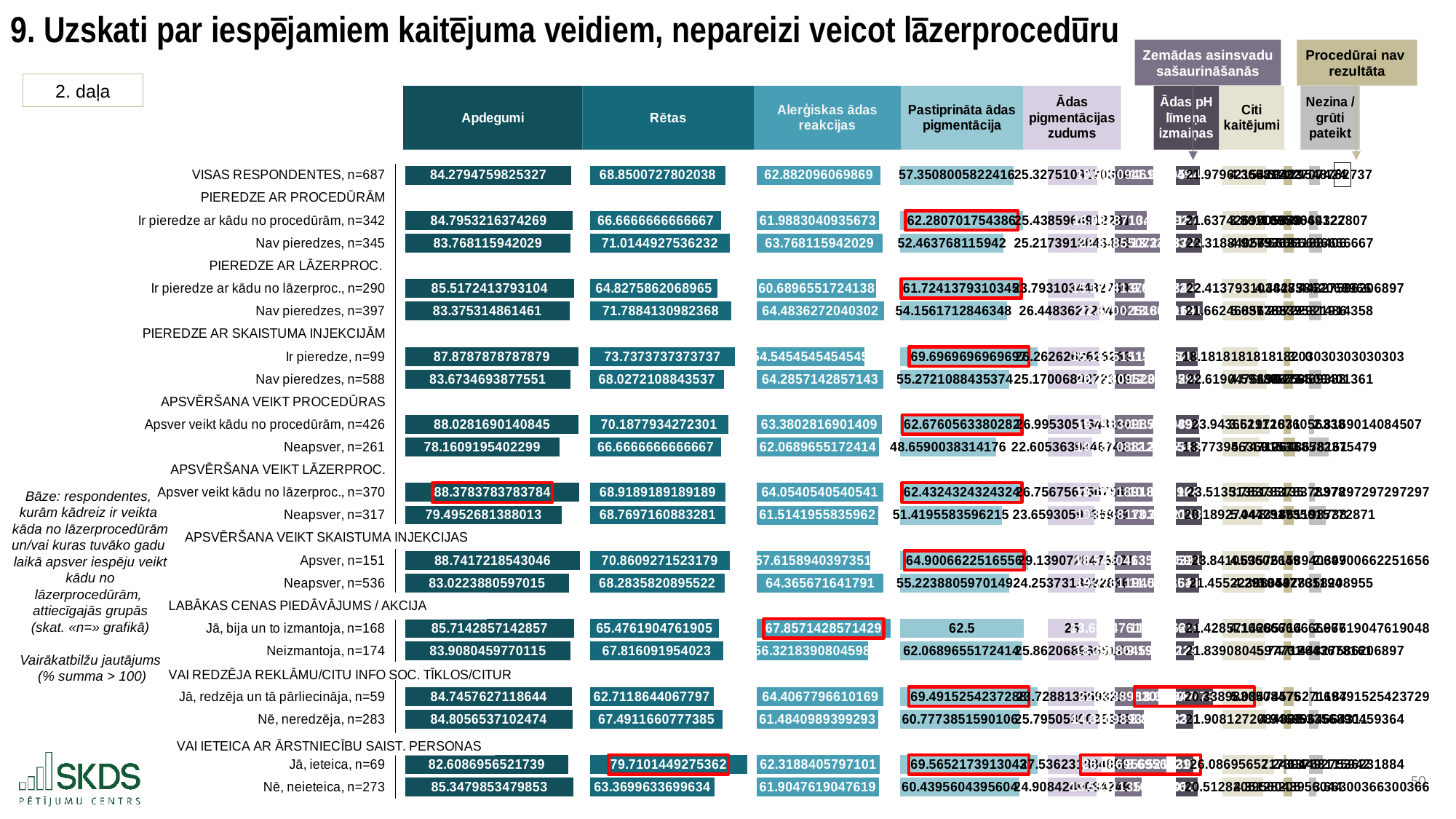
Which group has the lowest value for Apdegumi? Neapsver, n=261 Which series is shown in the darkest teal colour, first in the legend? Apdegumi What is the value for Apdegumi for VISAS RESPONDENTES, n=687? 84.2794759825327 What is the value for Rētas for Jā, ieteica, n=69? 79.7101449275362 Is the Apdegumi value for Neapsver, n=261 greater or less than 80? less What kind of chart is shown on the slide? bar chart What is the difference between the Apdegumi and Rētas values for VISAS RESPONDENTES, n=687? 15.4294032023289 Which is larger for Rētas: Ir pieredze ar kādu no procedūrām, n=342 or Nav pieredzes, n=345? Nav pieredzes, n=345 Which group has the highest value for Rētas? Jā, ieteica, n=69 What is the value for Alerģiskas ādas reakcijas for Ir pieredze, n=99? 54.5454545454545 What is the value for Pastiprināta ādas pigmentācija for Jā, bija un to izmantoja, n=168? 62.5 How many series does the legend list? 10